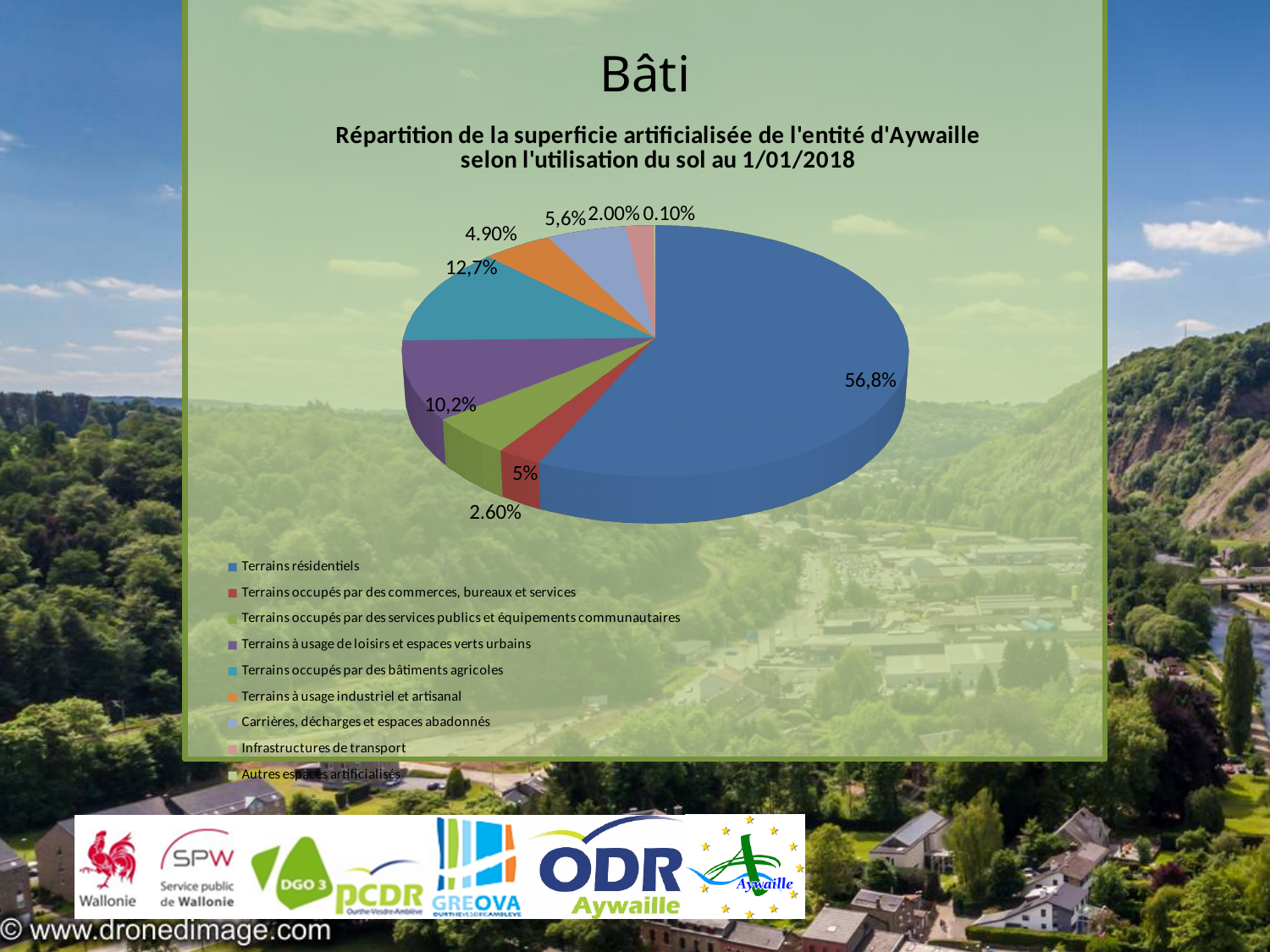
What share of the artificialised area is 'Terrains résidentiels'? 56,8% Which category has the largest share of the pie? Terrains résidentiels What is the difference between the shares for 'Terrains occupés par des bâtiments agricoles' and 'Terrains à usage de loisirs et espaces verts urbains'? 2,5% What percentage is shown for 'Terrains occupés par des bâtiments agricoles'? 12,7% Which is larger: the share for 'Terrains occupés par des bâtiments agricoles' or for 'Terrains à usage de loisirs et espaces verts urbains'? Terrains occupés par des bâtiments agricoles What type of chart is shown on the slide? pie chart What percentage is shown for 'Carrières, décharges et espaces abadonnés'? 5,6% How many categories does the legend list? 9 What is the title of the chart? Répartition de la superficie artificialisée de l'entité d'Aywaille selon l'utilisation du sol au 1/01/2018 What percentage is shown for 'Terrains occupés par des commerces, bureaux et services'? 2.60% Which category has the smallest share of the pie? Autres espaces artificialisés What percentage is shown for 'Terrains à usage de loisirs et espaces verts urbains'? 10,2%